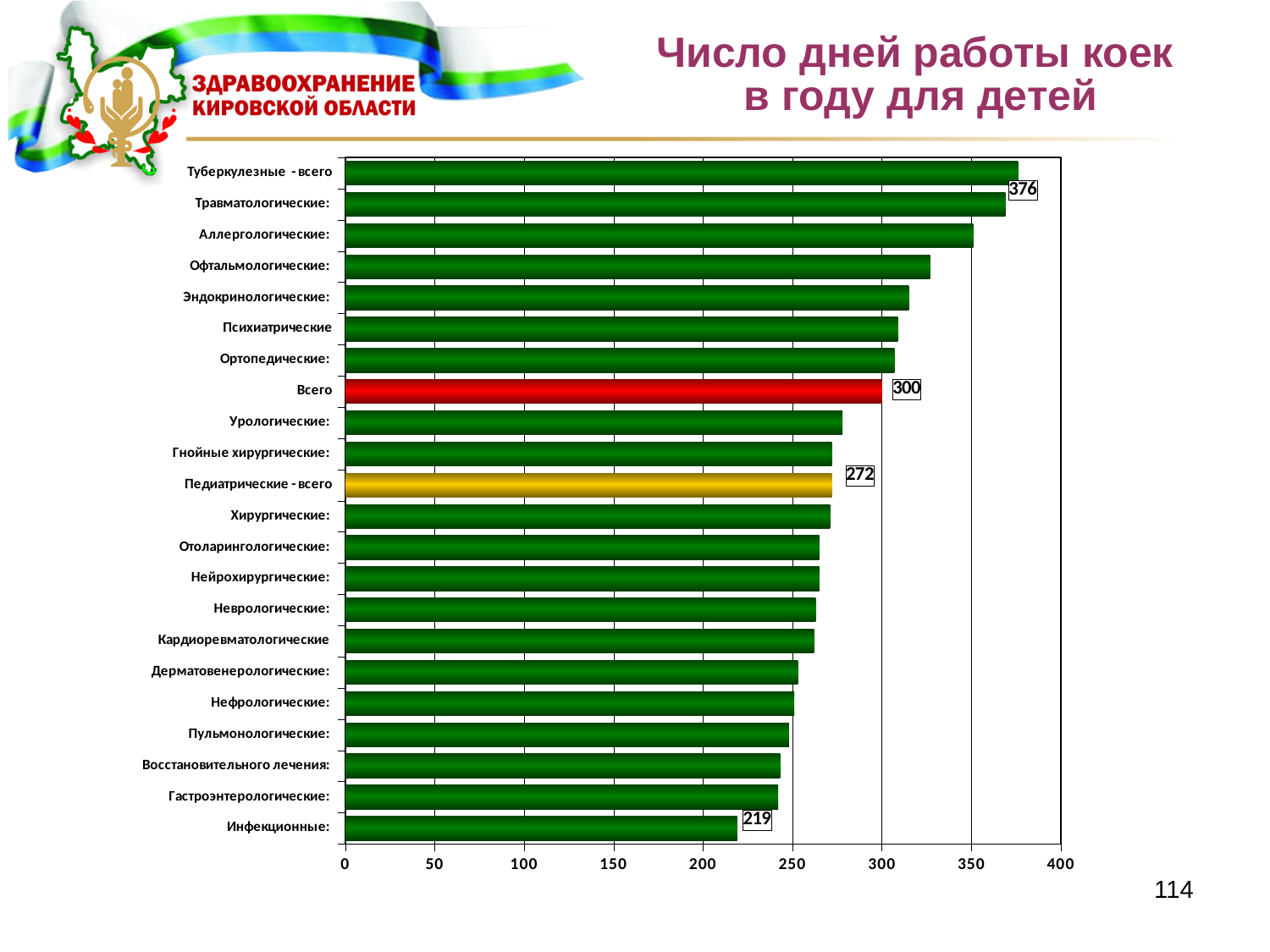
What is the value for Педиатрические - всего? 272 What is the difference between the values for Туберкулезные - всего and Инфекционные? 157 Is the value for Офтальмологические greater or less than 300? greater What is the value for Всего? 300 Which is larger, the value for Травматологические or the value for Урологические? Травматологические What is the difference between the values for Всего and Педиатрические - всего? 28 What is the value for Туберкулезные - всего? 376 How many categories are shown in the chart? 22 Which category has the lowest value? Инфекционные What is the value for Инфекционные? 219 Which category has the highest value? Туберкулезные - всего What type of chart is shown on the slide? bar chart